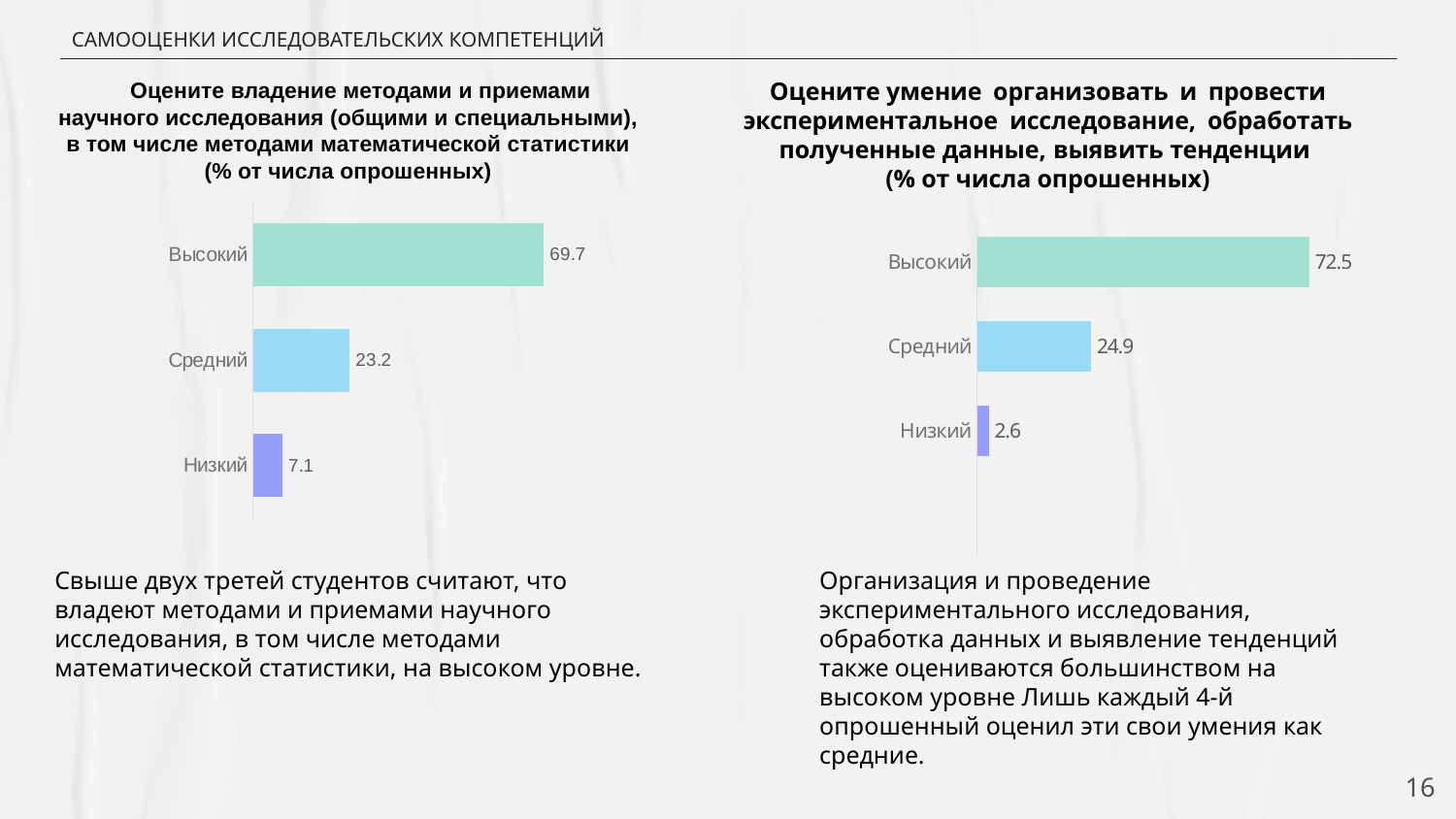
In the left chart, what is the value for Низкий? 7.1 How many categories does the left chart show? 3 In the left chart, what is the value for Высокий? 69.7 In the left chart, which category has the lowest value? Низкий In the left chart, what colour is the bar for Средний? Light blue In the right chart, what is the value for Низкий? 2.6 What type of chart is the right chart? Bar chart In the right chart, what is the difference between the values for Средний and Низкий? 22.3 In the right chart, which category has the highest value? Высокий In the left chart, what is the difference between the values for Высокий and Средний? 46.5 Which is larger: the value for Высокий in the left chart or the value for Высокий in the right chart? Right chart (72.5) In the right chart, what is the value for Средний? 24.9